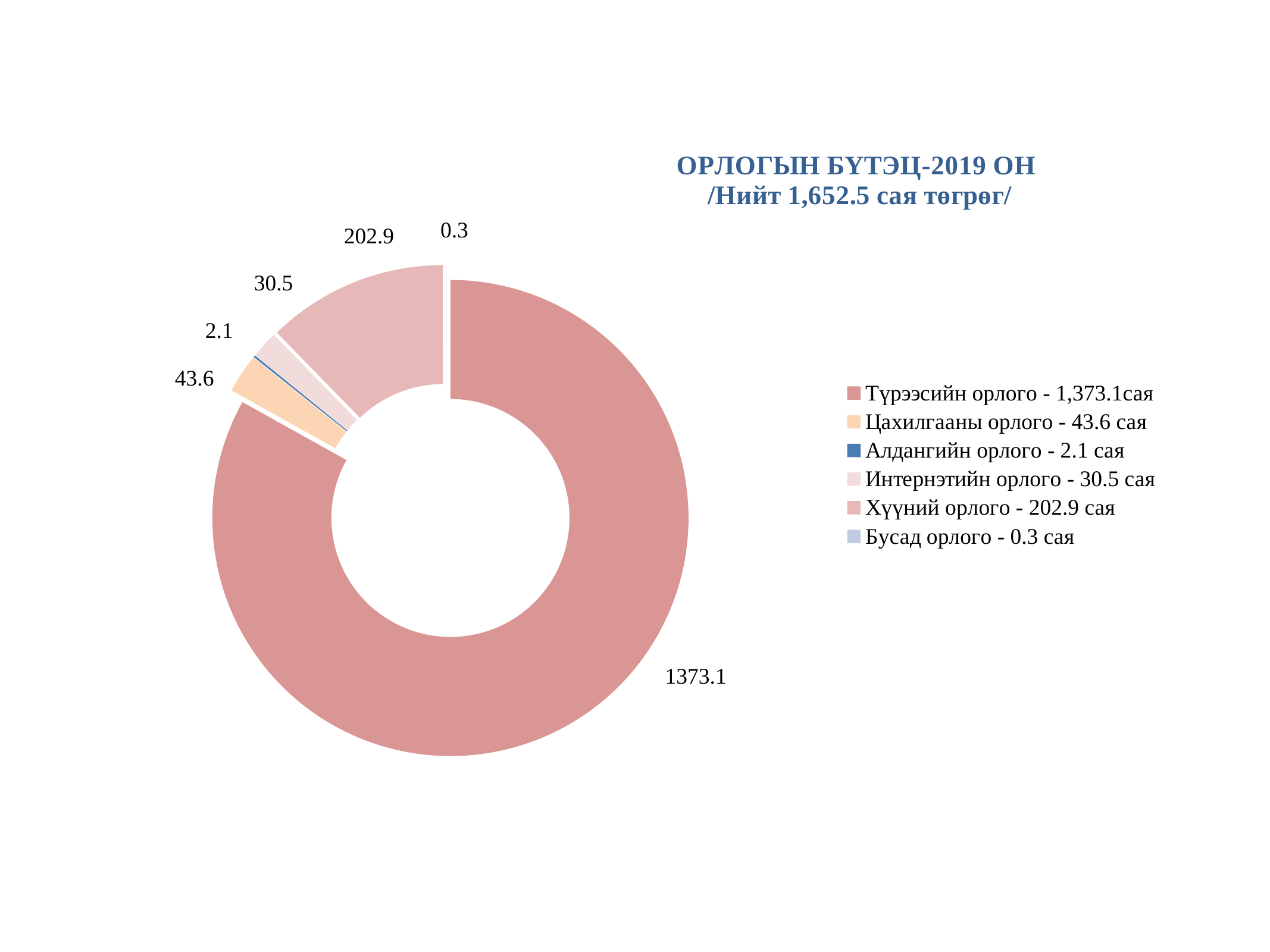
Which category has the smallest value? Бусад орлого What is the value for Интернэтийн орлого? 30.5 What is the value for Цахилгааны орлого? 43.6 What is the difference between Цахилгааны орлого and Интернэтийн орлого? 13.1 What total amount is stated in the chart title? 1,652.5 сая төгрөг What is the value for Түрээсийн орлого? 1373.1 Which category has the largest value? Түрээсийн орлого What kind of chart is shown on the slide? Doughnut chart What is the difference between Түрээсийн орлого and Хүүний орлого? 1170.2 How many categories does the chart show? 6 What is the value for Хүүний орлого? 202.9 Which is larger, Алдангийн орлого or Интернэтийн орлого? Интернэтийн орлого